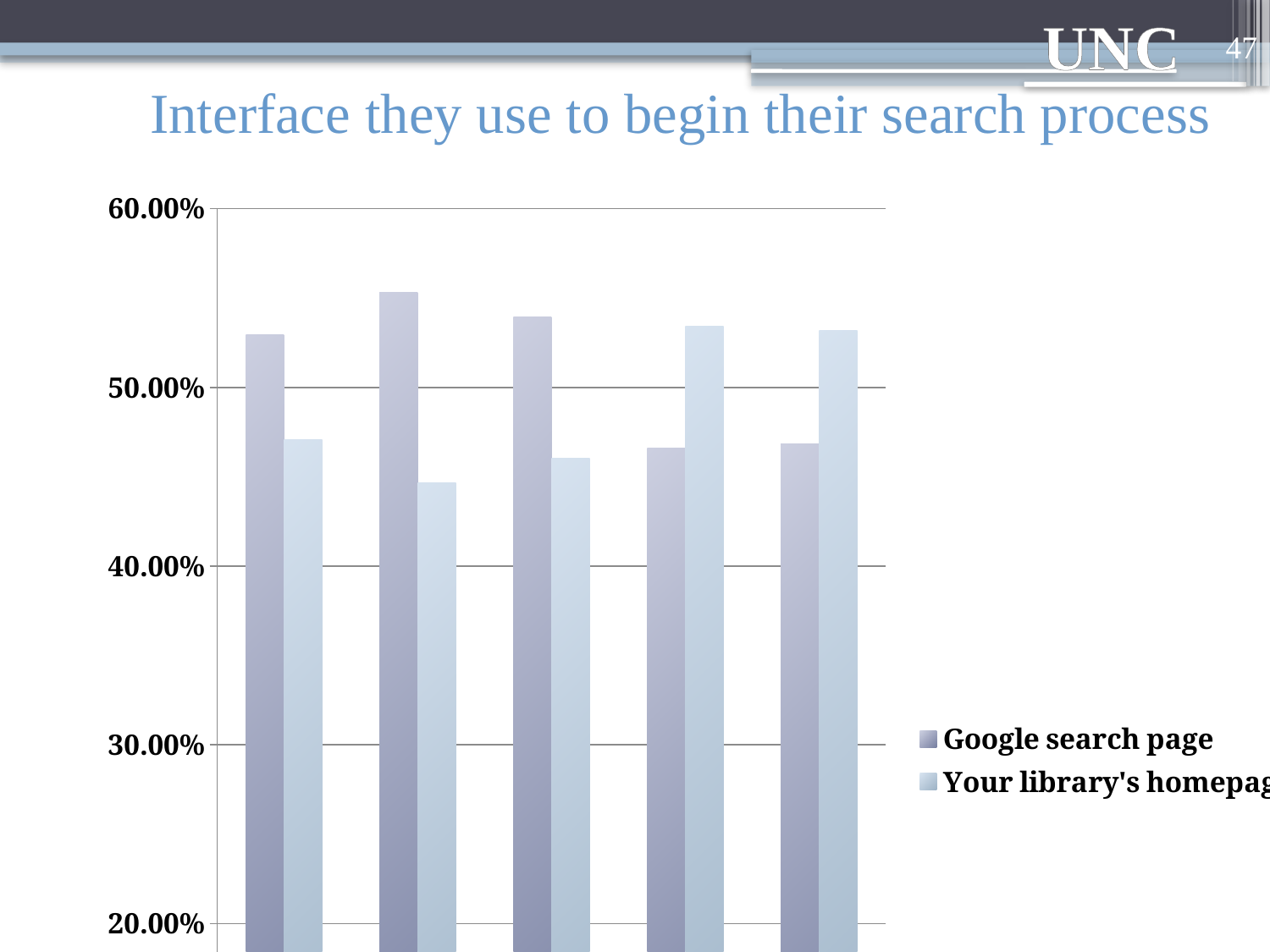
Is the value for Your library's homepage in the first (leftmost) group greater or less than 50.00%? less Is the value for Google search page in the first (leftmost) group greater or less than 50.00%? greater Is the value for Google search page in the fourth group from the left greater or less than 50.00%? less How many series does the legend list? 2 Which series is listed first in the legend? Google search page In which group from the left is the Google search page bar the tallest? second group What is the title of the slide containing the chart? Interface they use to begin their search process In the first (leftmost) group, which series has the larger value, Google search page or Your library's homepage? Google search page What kind of chart is shown on the slide? bar chart In the fifth (rightmost) group, which series has the larger value, Google search page or Your library's homepage? Your library's homepage How many groups of bars are plotted along the x axis? 5